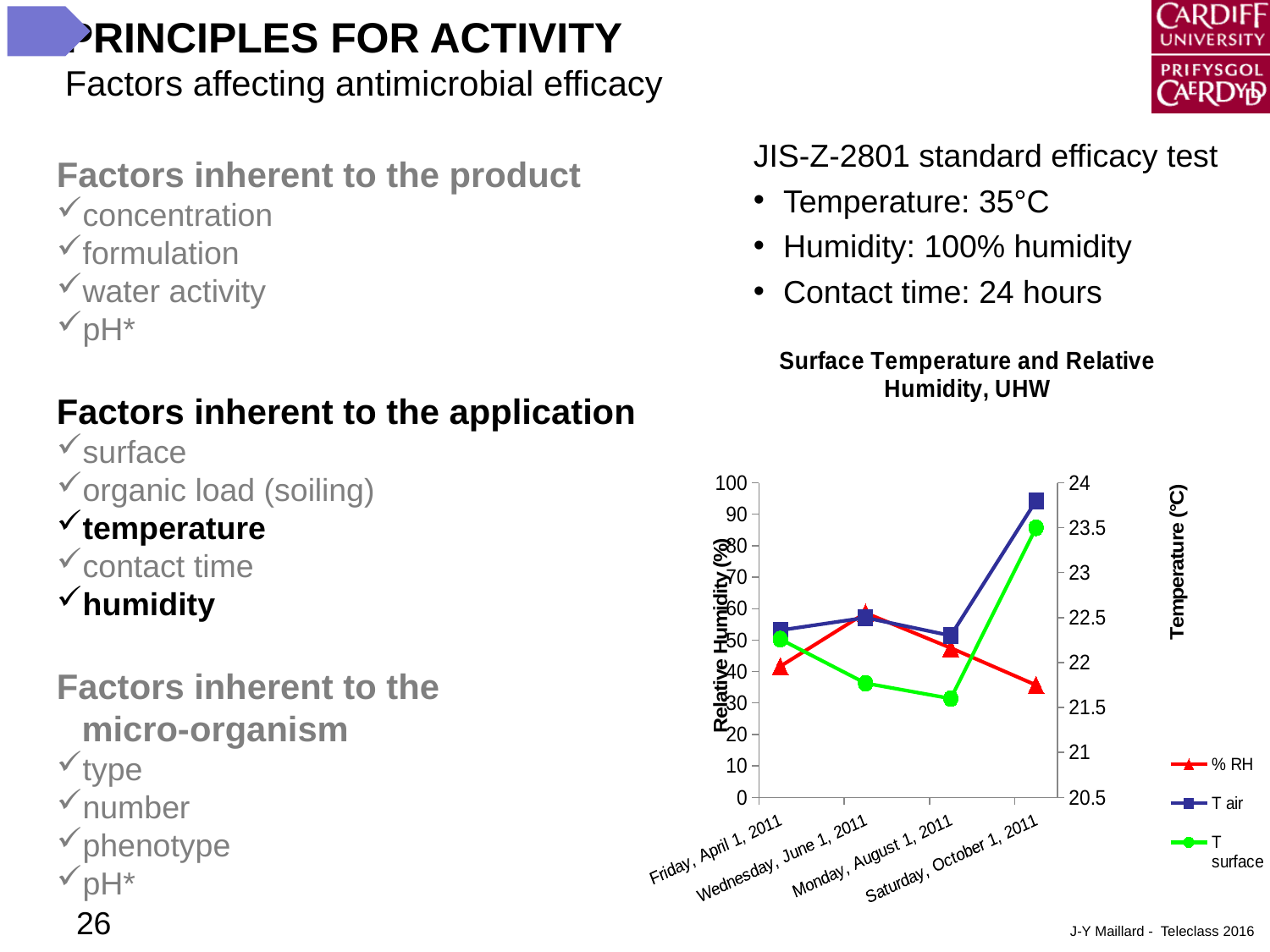
Is the % RH value on Saturday, October 1, 2011 greater or less than 40? less Does the T surface value rise or fall between Monday, August 1, 2011 and Saturday, October 1, 2011? rise Is the T air value on Saturday, October 1, 2011 greater or less than 23.5? greater How many dates are plotted along the x axis of the chart? 4 What is the title of the chart? Surface Temperature and Relative Humidity, UHW On which date is the % RH value highest? Wednesday, June 1, 2011 On which date is the T surface value lowest? Monday, August 1, 2011 Which is larger, the % RH value on Friday, April 1, 2011 or on Wednesday, June 1, 2011? Wednesday, June 1, 2011 On which date is the T air value highest? Saturday, October 1, 2011 What kind of chart is shown on the slide? line chart How many series does the chart legend list? 3 Is the % RH value on Wednesday, June 1, 2011 greater or less than 50? greater